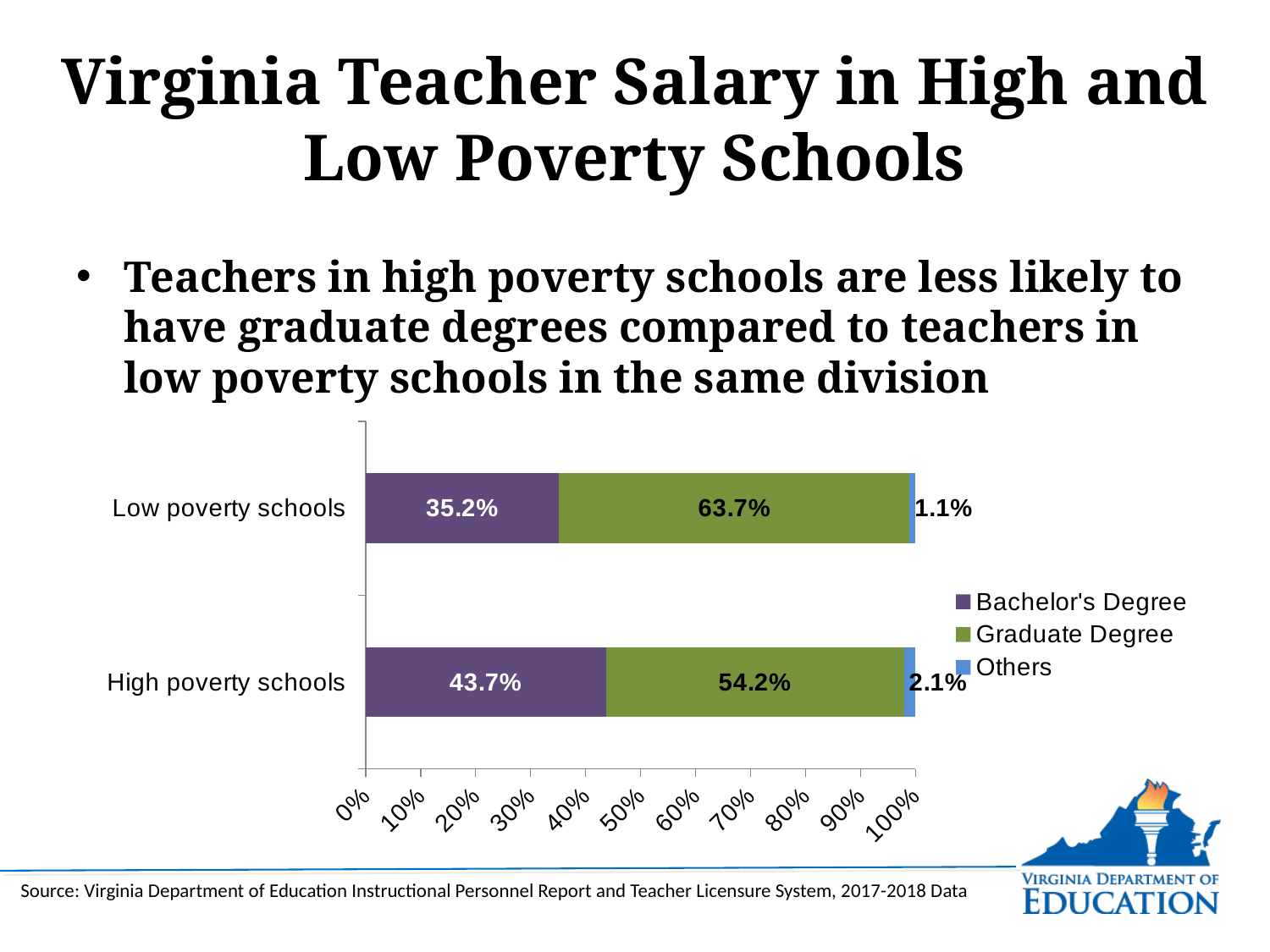
What percentage of teachers in high poverty schools have a Bachelor's Degree? 43.7% What is the difference in Bachelor's Degree percentage between high poverty schools and low poverty schools? 8.5 percentage points What is the value for Others in low poverty schools? 1.1% What kind of chart is shown on the slide? Stacked bar chart What percentage of teachers in low poverty schools have a Graduate Degree? 63.7% What is the difference in Graduate Degree percentage between low poverty schools and high poverty schools? 9.5 percentage points Is the Bachelor's Degree share in high poverty schools larger or smaller than the Graduate Degree share in high poverty schools? smaller How many series does the legend list? 3 Which school category has the lower Bachelor's Degree percentage? Low poverty schools Which school category has the higher Graduate Degree percentage? Low poverty schools How many school categories are shown on the chart? 2 What is the value for Others in high poverty schools? 2.1%